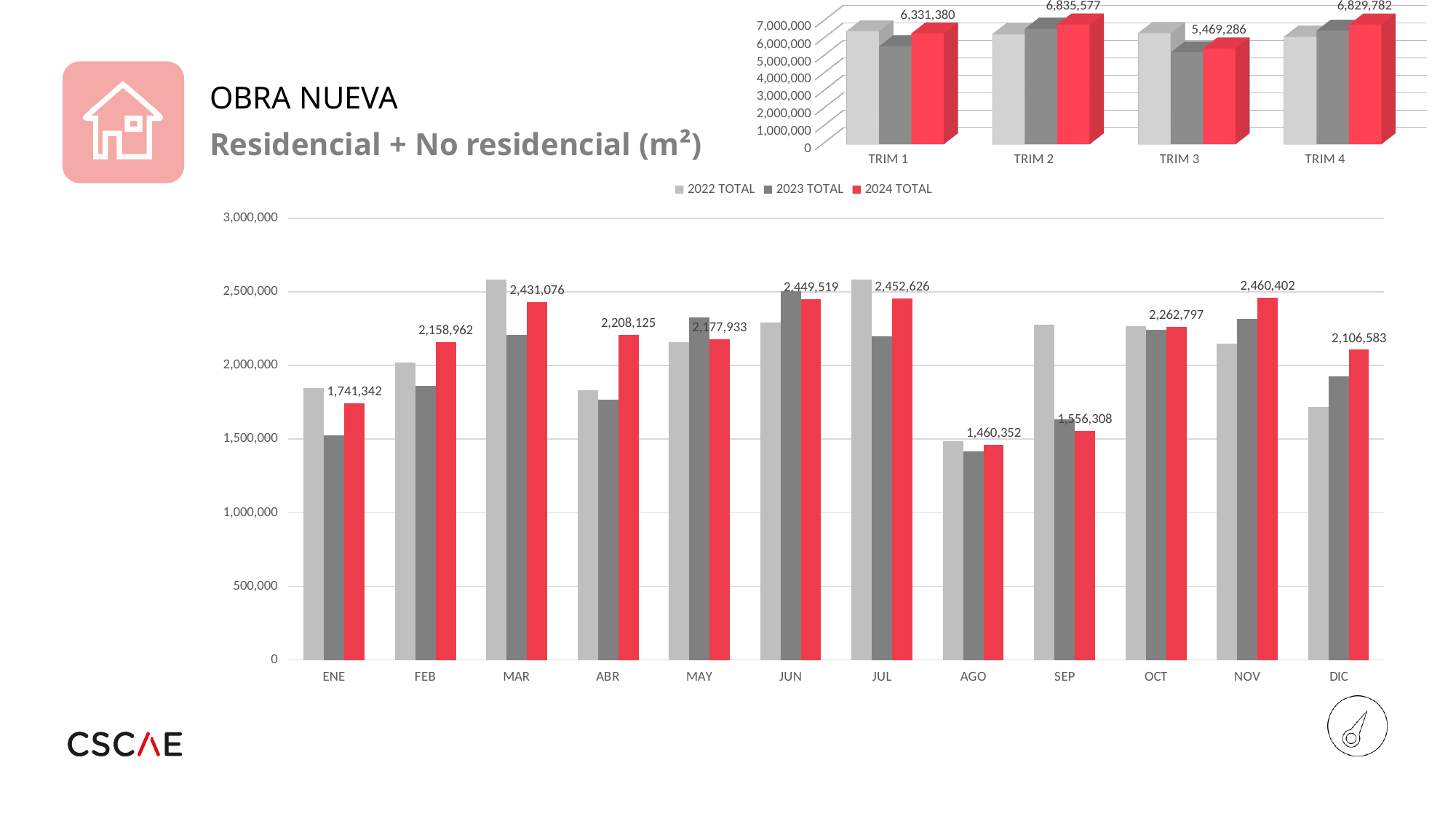
In the monthly chart at the bottom, is the 2022 TOTAL value for MAR greater or less than 2,500,000? greater What kind of chart is the monthly chart at the bottom of the slide? Bar chart In the quarterly chart at the top right, what is the difference between the 2024 TOTAL values for TRIM 2 and TRIM 3? 1,366,291 How many months are shown on the x axis of the monthly chart at the bottom? 12 In the monthly chart at the bottom, is the 2023 TOTAL value for ENE greater or less than 2,000,000? less In the monthly chart at the bottom, which month has the lowest 2024 TOTAL value? AGO In the monthly chart at the bottom, what is the 2024 TOTAL value for NOV? 2,460,402 In the monthly chart at the bottom, what is the 2024 TOTAL value for AGO? 1,460,352 In the quarterly chart at the top right, which quarter has the highest 2024 TOTAL value? TRIM 2 How many series does the legend list for the charts on this slide? 3 In the quarterly chart at the top right, what is the 2024 TOTAL value for TRIM 3? 5,469,286 In the monthly chart at the bottom, which is larger: the 2024 TOTAL value for FEB or for ABR? ABR